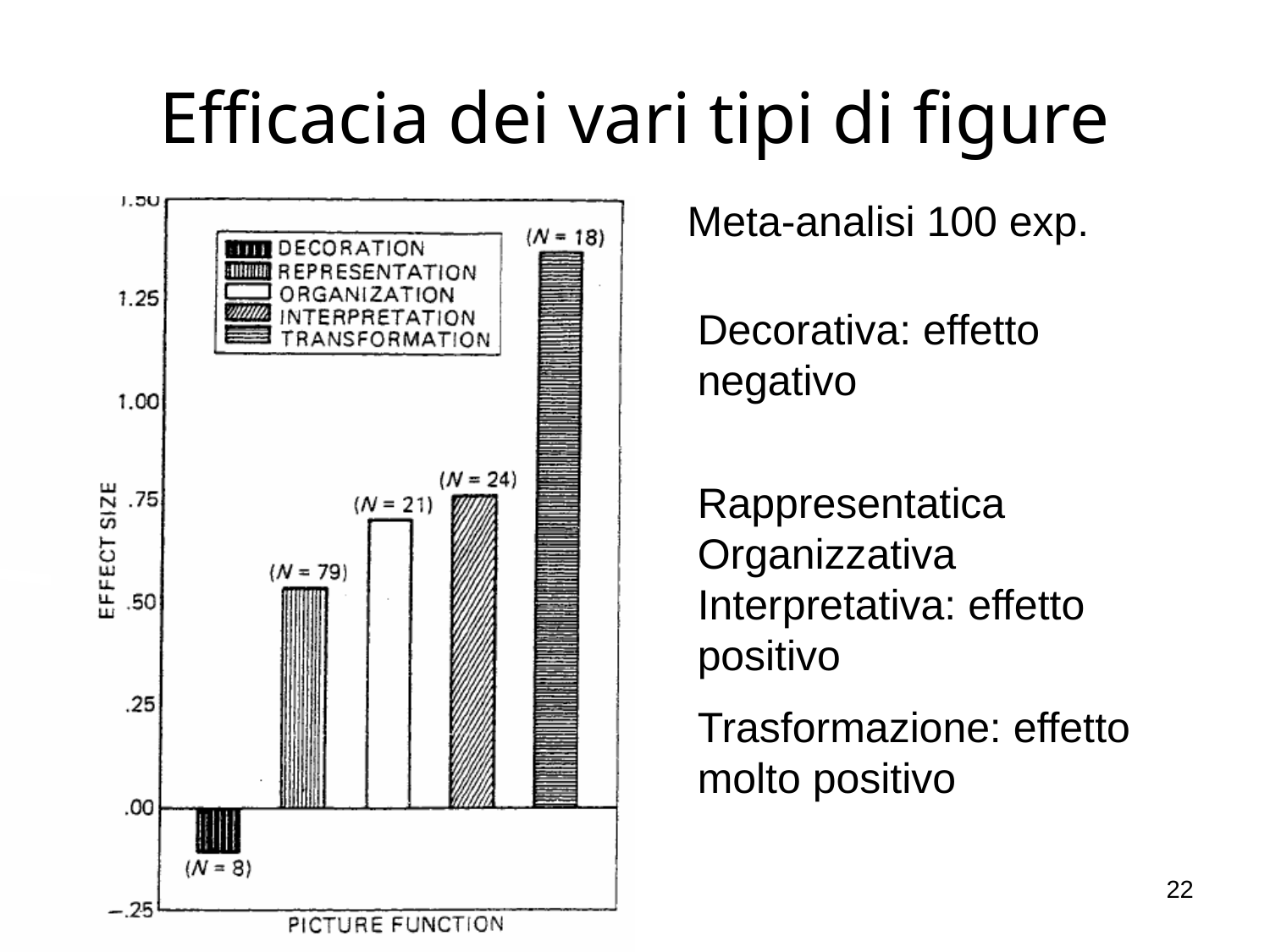
What is the N value shown for the Representation bar? N = 79 What is the label of the vertical axis of the chart? EFFECT SIZE How many bars (picture functions) are plotted in the chart? 5 Is the effect size for Decoration greater or less than .00? less What is the N value shown for the Decoration bar? N = 8 How many entries does the chart's legend list? 5 What kind of chart is shown on the slide? bar chart What is the N value shown for the Transformation bar? N = 18 Is the effect size for Transformation greater or less than 1.25? greater Which has a larger effect size, Organization or Representation? Organization Which picture function has the lowest effect size? Decoration Which picture function has the highest effect size? Transformation